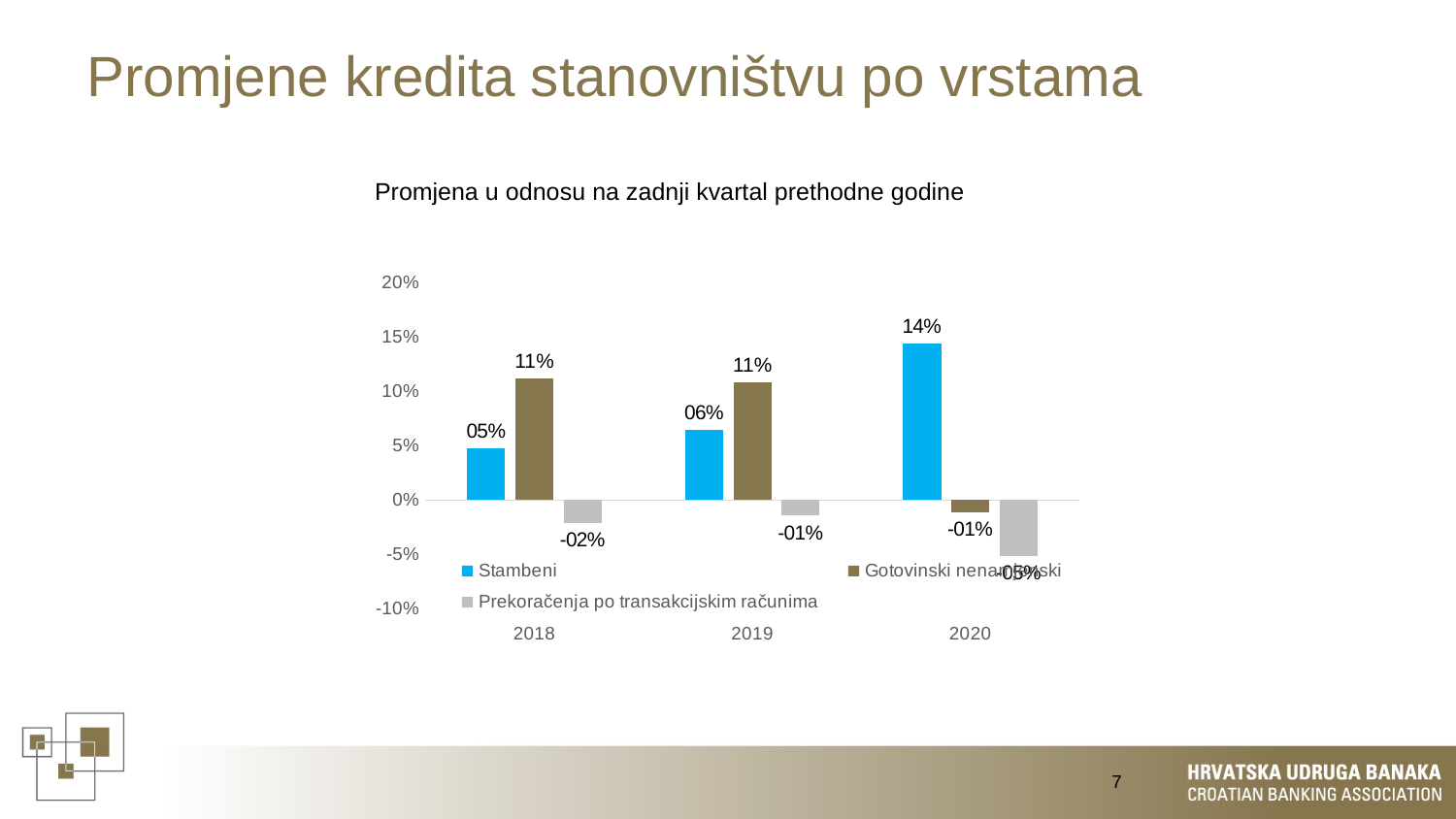
In 2019, which is larger: Stambeni or Gotovinski nenamjenski? Gotovinski nenamjenski How many years are shown on the x axis? 3 What is the difference between the Stambeni value in 2020 and in 2018? 09% What is the value for Prekoračenja po transakcijskim računima in 2018? -02% What is the value for Gotovinski nenamjenski in 2020? -01% How many series does the legend list? 3 What is the value for Gotovinski nenamjenski in 2018? 11% In which year is the Stambeni value highest? 2020 What is the value for Stambeni in 2020? 14% What is the value for Stambeni in 2018? 05% What kind of chart is shown on the slide? bar chart Do the Stambeni values rise or fall from 2018 to 2020? rise